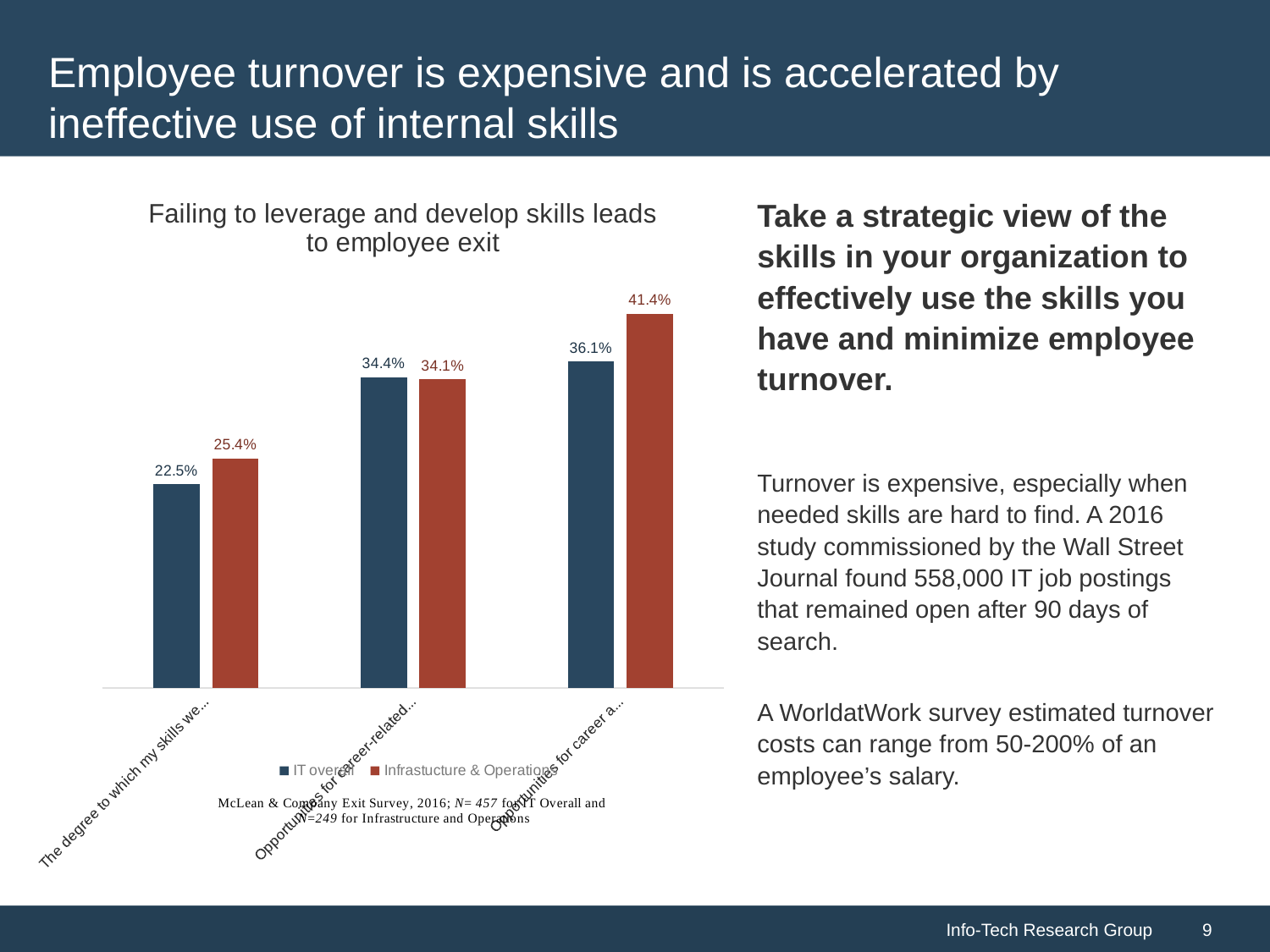
Which bar has the highest value in the chart? Infrastructure & Operations, third category (41.4%) How many categories are plotted along the x axis of the chart? 3 Do the IT overall values rise or fall from the first category to the third category? Rise Which bar has the lowest value in the chart? IT overall, first category (22.5%) What kind of chart is shown on the slide? Bar chart How many series does the chart legend list? 2 What is the IT overall value for the first category ("The degree to which my skills we...")? 22.5% In the third category, what is the difference between the Infrastructure & Operations value and the IT overall value? 5.3 percentage points In the first category, which series has the larger value, IT overall or Infrastructure & Operations? Infrastructure & Operations What is the Infrastructure & Operations value for the third category ("Opportunities for career a...")? 41.4% What is the IT overall value for the second category ("Opportunities for career-related...")? 34.4% What is the title of the chart? Failing to leverage and develop skills leads to employee exit